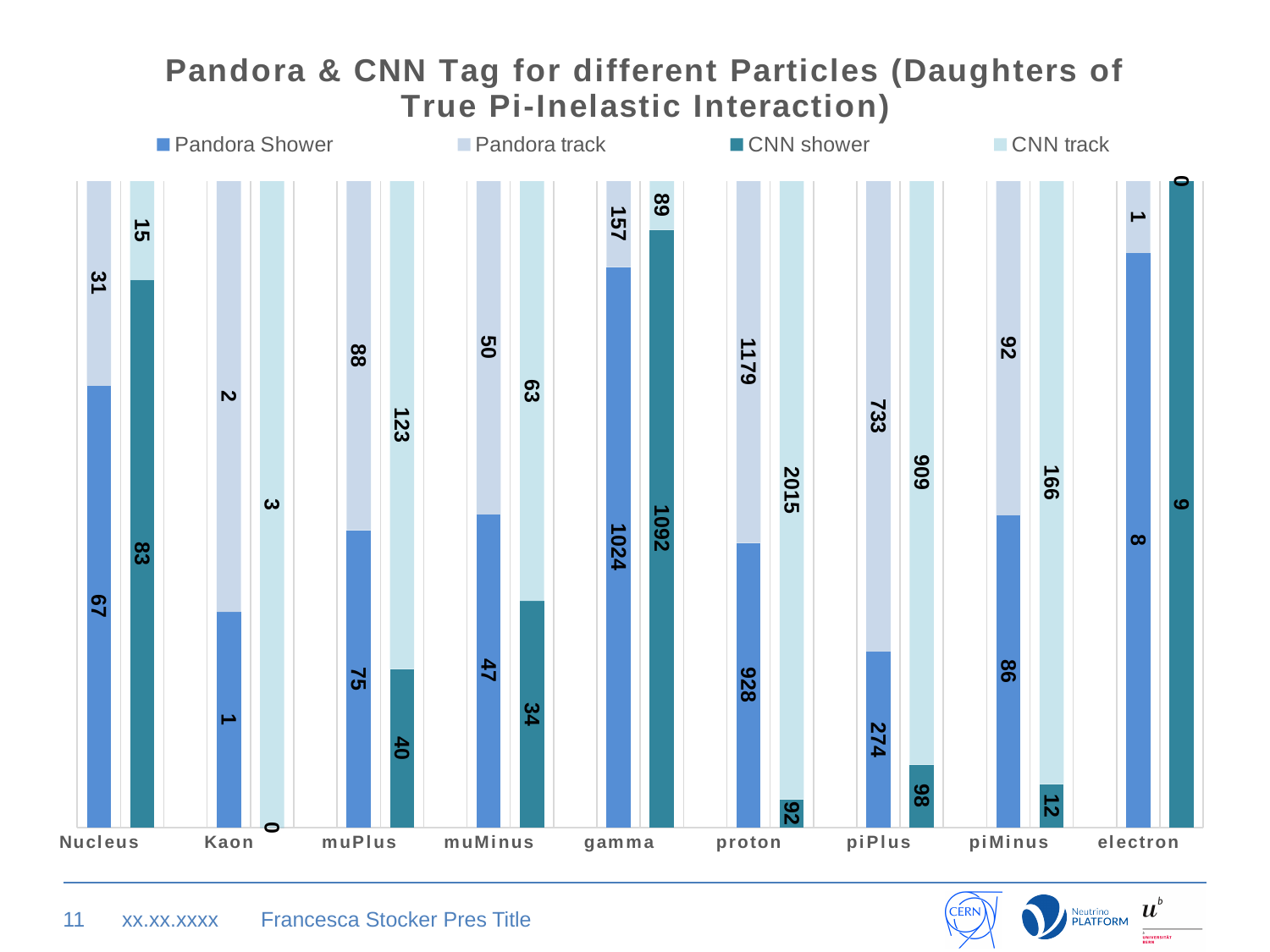
How many series does the legend list? 4 What is the Pandora Shower value for gamma? 1024 Which is larger for piMinus: the Pandora track value or the CNN track value? CNN track How many particle categories are shown on the x axis? 9 Which particle has the highest CNN track value? proton What kind of chart is shown on the slide? Stacked bar chart What is the Pandora track value for muPlus? 88 What is the CNN track value for proton? 2015 What is the difference between the CNN shower value for gamma and the CNN shower value for Nucleus? 1009 What is the CNN shower value for piPlus? 98 What is the total of the Pandora bar (Pandora Shower plus Pandora track) for proton? 2107 Which particle has the lowest Pandora Shower value? Kaon